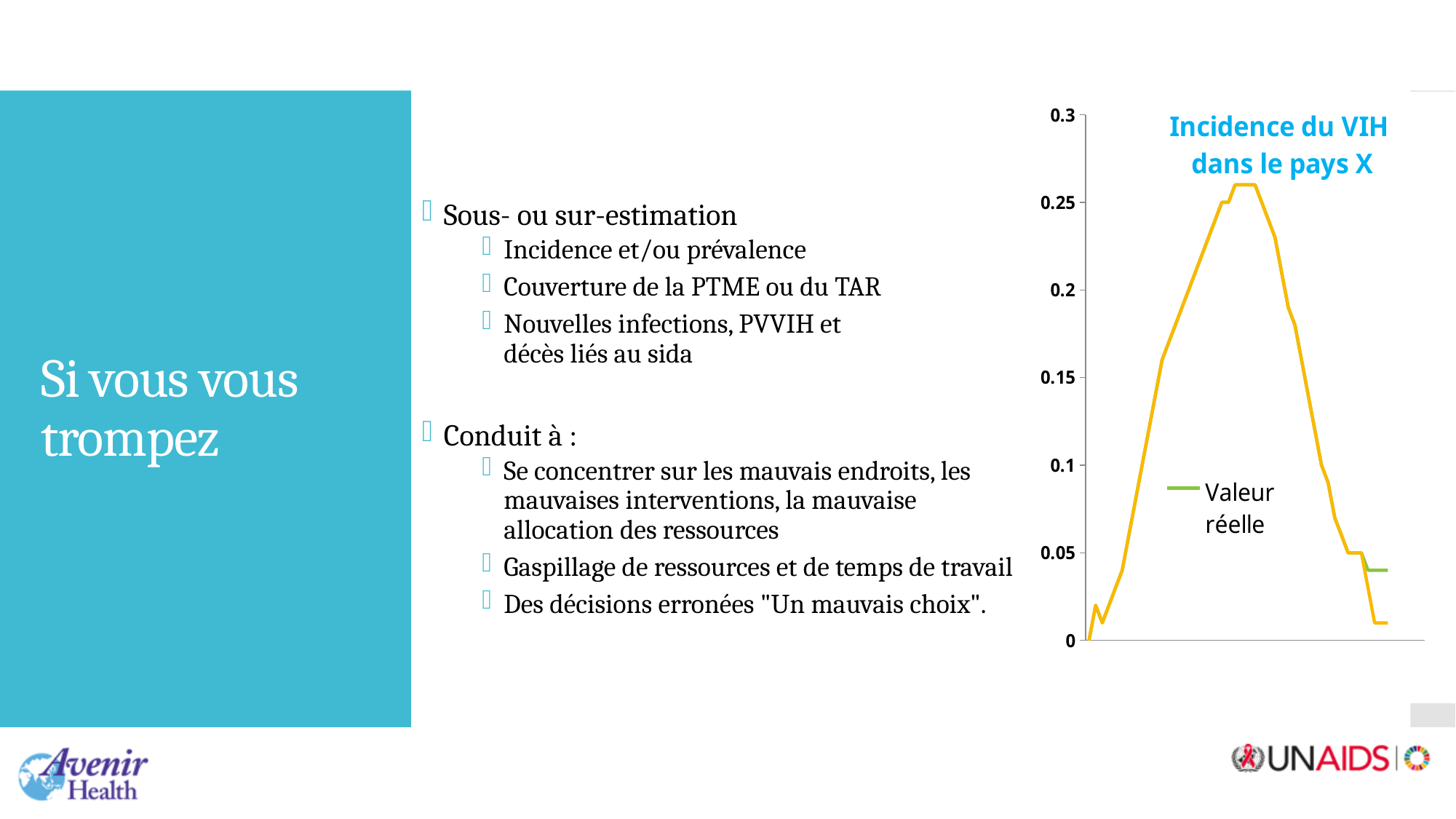
Does the yellow line rise or fall over the left-hand half of the chart? rise Is the value of the yellow line at its left-hand end greater or less than 0.05? less Which is larger: the peak of the yellow line or the value of the green 'Valeur réelle' line? the peak of the yellow line How many entries does the chart's legend list? 1 What is the label of the entry shown in the chart's legend? Valeur réelle Is the value of the yellow line at its right-hand end greater or less than 0.05? less Is the value of the green 'Valeur réelle' line greater or less than 0.1? less What is the title of the chart on the slide? Incidence du VIH dans le pays X What kind of chart is shown on the slide? line chart Does the yellow line rise or fall over the right-hand half of the chart? fall What is the highest value shown on the chart's vertical axis? 0.3